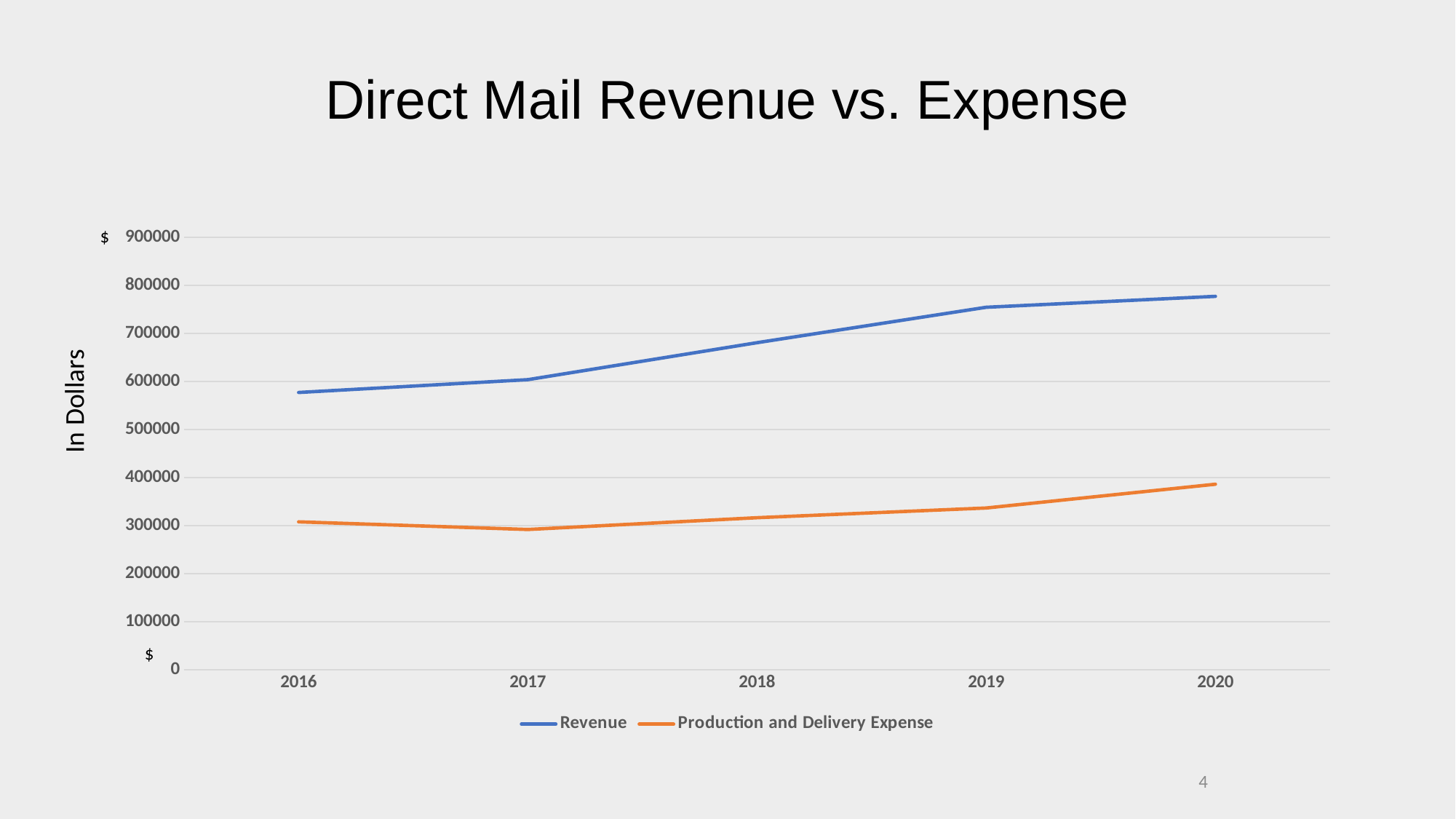
Is the Revenue value for 2016 greater or less than 600000? less In which year is Production and Delivery Expense highest? 2020 Is the Production and Delivery Expense value for 2020 greater or less than 400000? less Does Revenue generally rise or fall from 2016 to 2020? rise In which year is Revenue highest? 2020 How many series does the legend list? 2 How many years are plotted along the x axis? 5 Is the Revenue value for 2019 greater or less than 700000? greater What kind of chart is shown on the slide? line chart What is the title of the chart? Direct Mail Revenue vs. Expense In which year is Production and Delivery Expense lowest? 2017 In which year is Revenue lowest? 2016